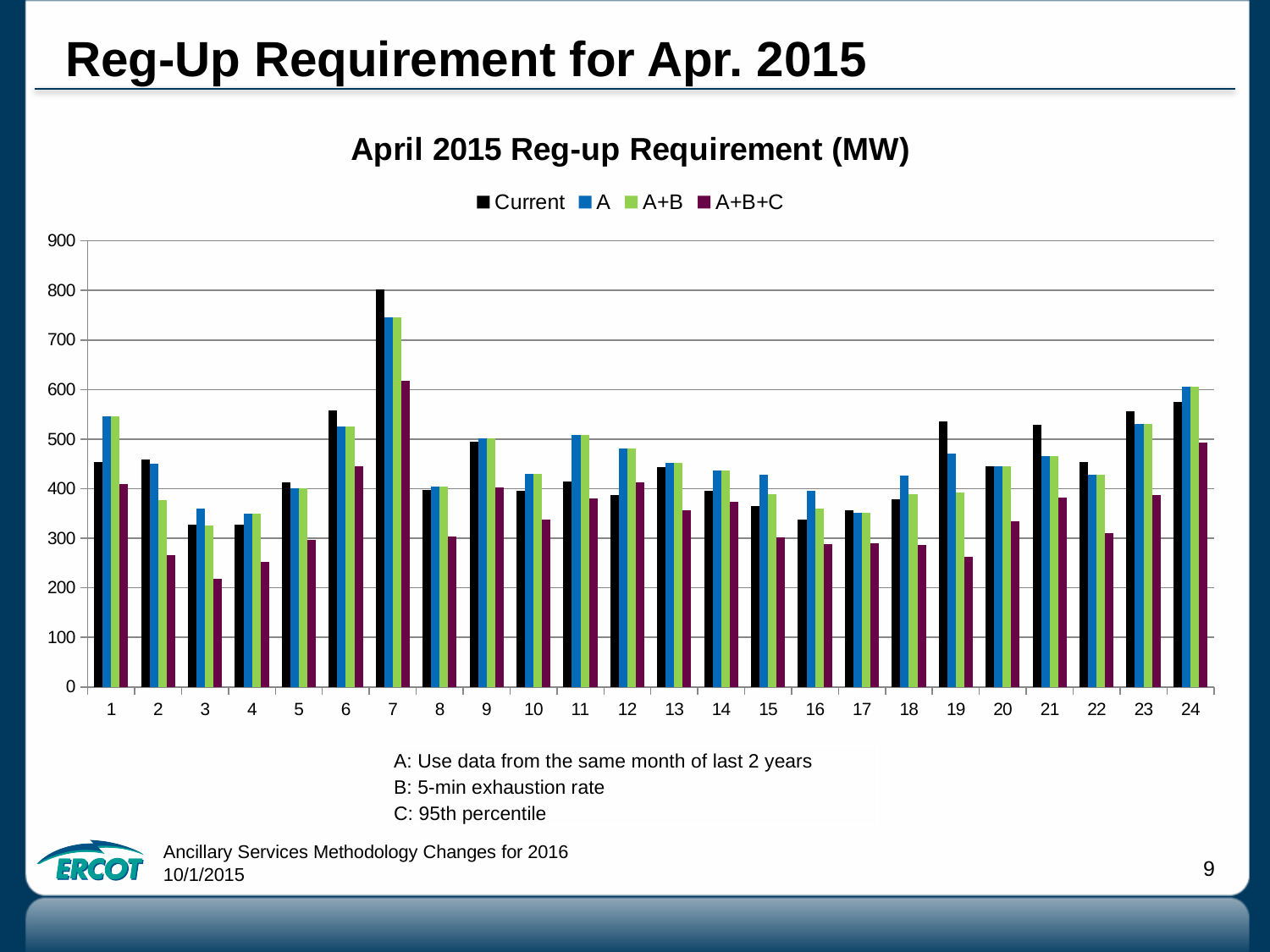
How many hour categories are shown on the x axis? 24 What is the title of the chart? April 2015 Reg-up Requirement (MW) Which hour has the lowest A+B+C value? 3 Which is larger, the A+B+C value for hour 24 or the A+B+C value for hour 23? hour 24 Is the A+B+C value for hour 19 greater or less than 300? less Which hour has the highest Current value? 7 Is the Current value for hour 7 greater or less than 700? greater How many series does the legend list? 4 Is the A value for hour 24 greater or less than 500? greater What kind of chart is shown on the slide? bar chart Which is larger, the Current value for hour 7 or the Current value for hour 6? hour 7